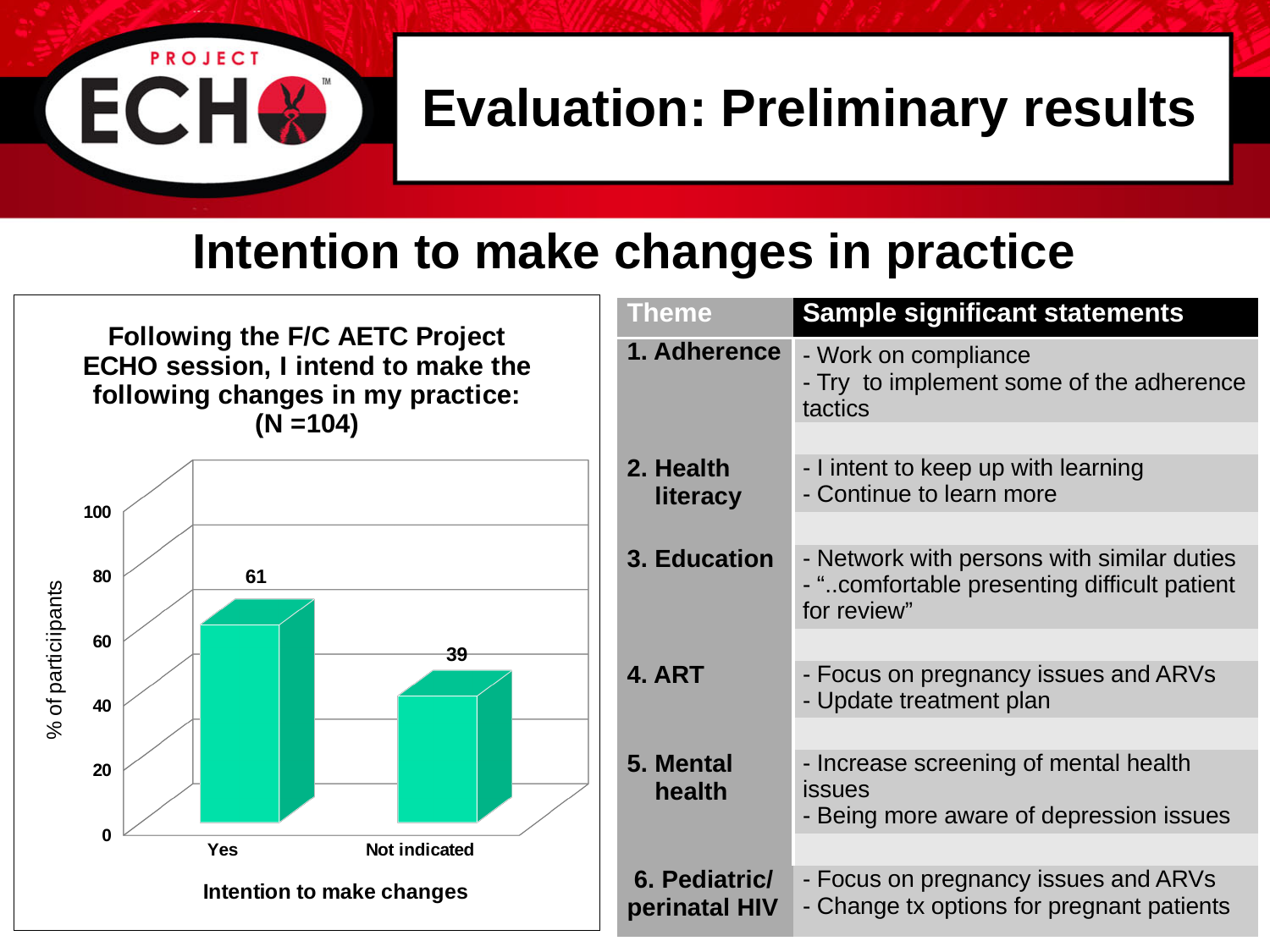
What is the value for "Not indicated" in the chart? 39 What is the difference between the values for "Yes" and "Not indicated"? 22 Is the value for "Yes" greater or less than 60? greater Which category has the highest value in the chart? Yes What is the label of the y axis of the chart? % of particiipants Which is larger, the value for "Yes" or the value for "Not indicated"? Yes How many categories are shown on the x axis of the chart? 2 Which category has the lowest value in the chart? Not indicated What kind of chart is shown on the slide? bar chart What is the label of the x axis of the chart? Intention to make changes What is the value for "Yes" in the chart? 61 Is the value for "Not indicated" greater or less than 40? less